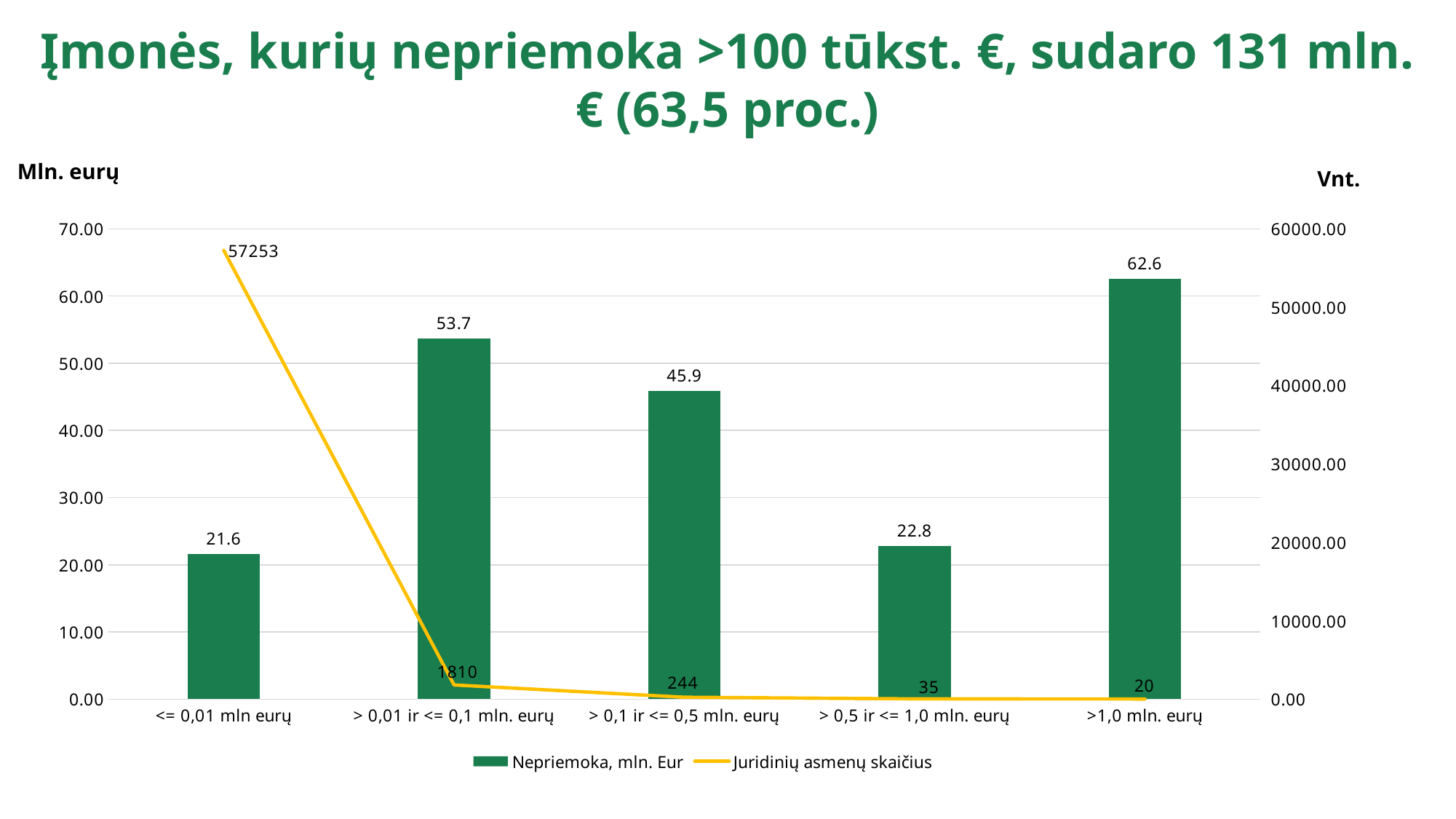
Which category has the highest Nepriemoka, mln. Eur? >1,0 mln. eurų How many categories are shown on the x axis? 5 What is the Juridinių asmenų skaičius for the category '> 0,5 ir <= 1,0 mln. eurų'? 35 What is the value of Nepriemoka, mln. Eur for the category '>1,0 mln. eurų'? 62.6 What is the difference in Nepriemoka, mln. Eur between '> 0,01 ir <= 0,1 mln. eurų' and '> 0,5 ir <= 1,0 mln. eurų'? 30.9 What is the Juridinių asmenų skaičius for the category '<= 0,01 mln eurų'? 57253 How many series does the legend list? 2 Which has a larger Nepriemoka, mln. Eur: '> 0,01 ir <= 0,1 mln. eurų' or '> 0,1 ir <= 0,5 mln. eurų'? > 0,01 ir <= 0,1 mln. eurų What is the value of Nepriemoka, mln. Eur for the category '> 0,1 ir <= 0,5 mln. eurų'? 45.9 Which category has the lowest Nepriemoka, mln. Eur? <= 0,01 mln eurų Which category has the lowest Juridinių asmenų skaičius? >1,0 mln. eurų Does the Juridinių asmenų skaičius line rise or fall from the first category to the last? fall